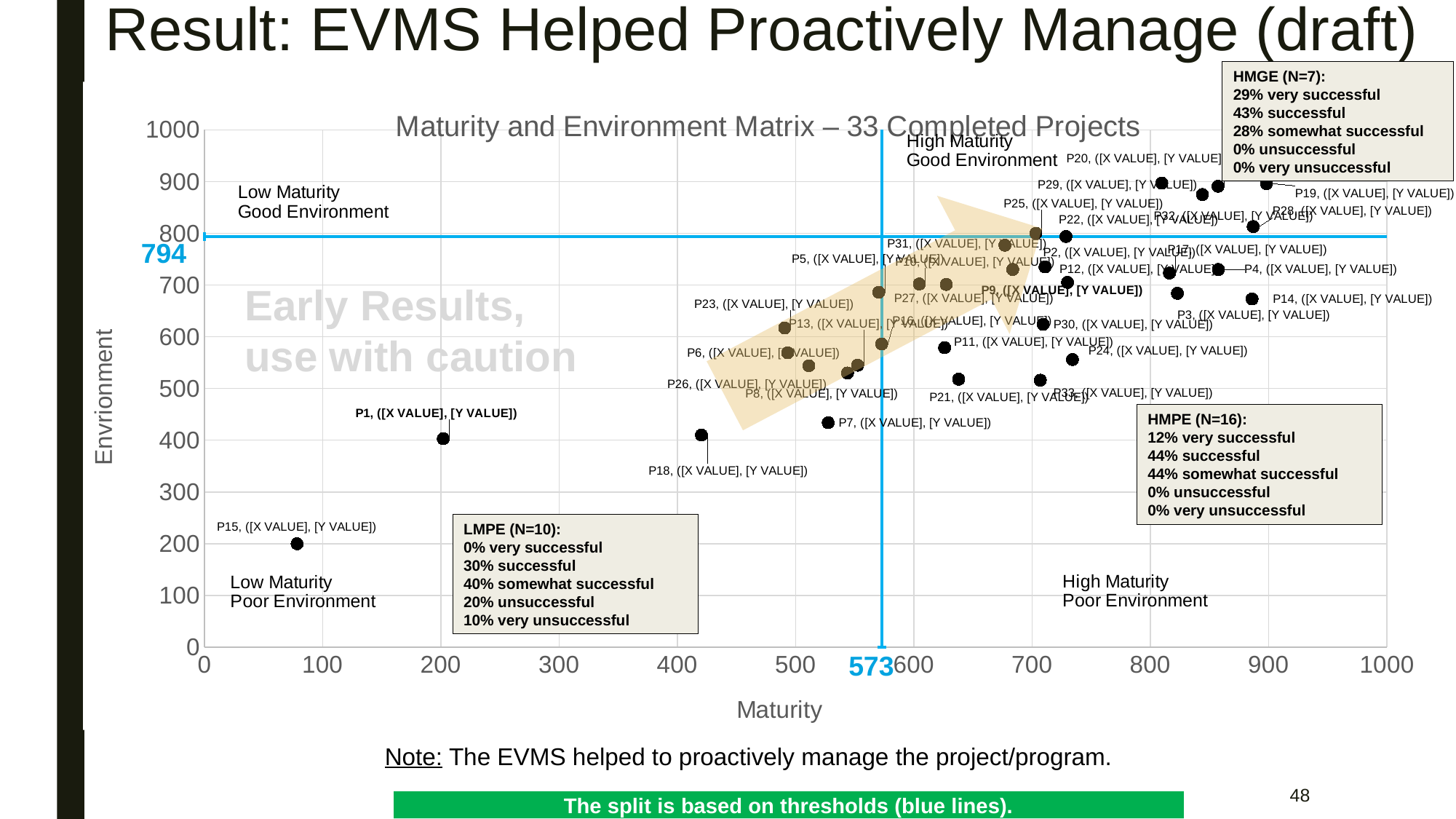
What environment threshold value is marked by the horizontal blue line? 794 Is the Maturity value for P1 greater or less than 300? less What maturity threshold value is marked by the vertical blue line? 573 What is the title of the chart? Maturity and Environment Matrix – 33 Completed Projects Which project point has the lowest Maturity value? P15 What kind of chart is shown on the slide? Scatter chart What is the label of the horizontal axis of the chart? Maturity Is the Environment value for P19 greater or less than 800? greater Which has the larger Maturity value, P18 or P7? P7 Which project point has the lowest Environment value? P15 Is the Environment value for P15 greater or less than 300? less